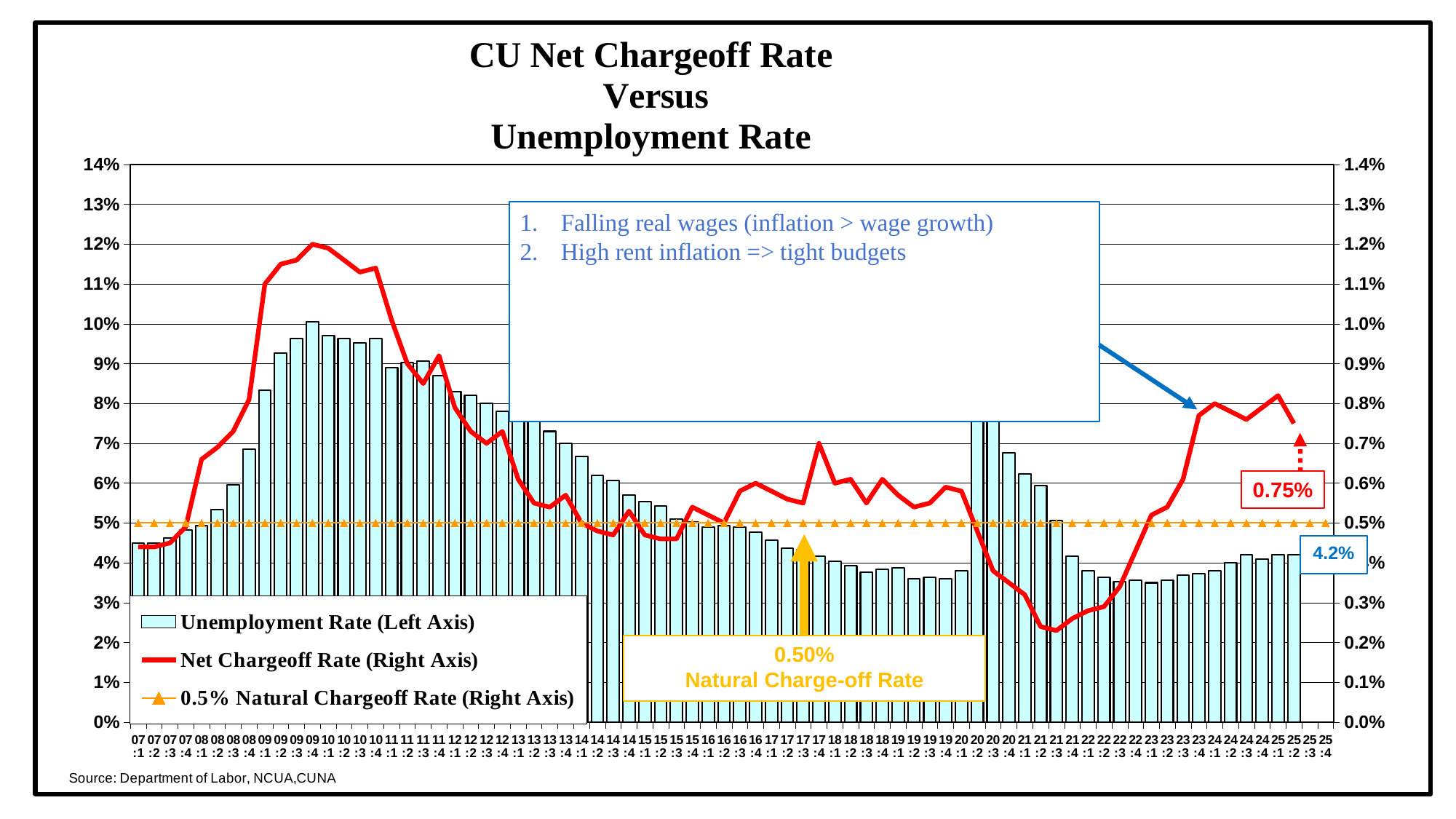
Is the net chargeoff rate for 09:4 greater or less than 1.1%? greater What value is labelled for the unemployment rate at the end of the series? 4.2% Is the unemployment rate for 07:1 greater or less than 5%? less What kind of chart is shown on the slide? A combined bar and line chart How many series does the legend list? 3 What value is labelled in the red box for the projected net chargeoff rate? 0.75% What value is the Natural Charge-off Rate line set at? 0.50% Is the net chargeoff rate for 21:3 greater or less than 0.3%? less Which is larger, the unemployment rate for 09:4 or for 19:4? 09:4 Does the net chargeoff rate rise or fall from 21:3 to 23:4? rise What is the title of the chart? CU Net Chargeoff Rate Versus Unemployment Rate